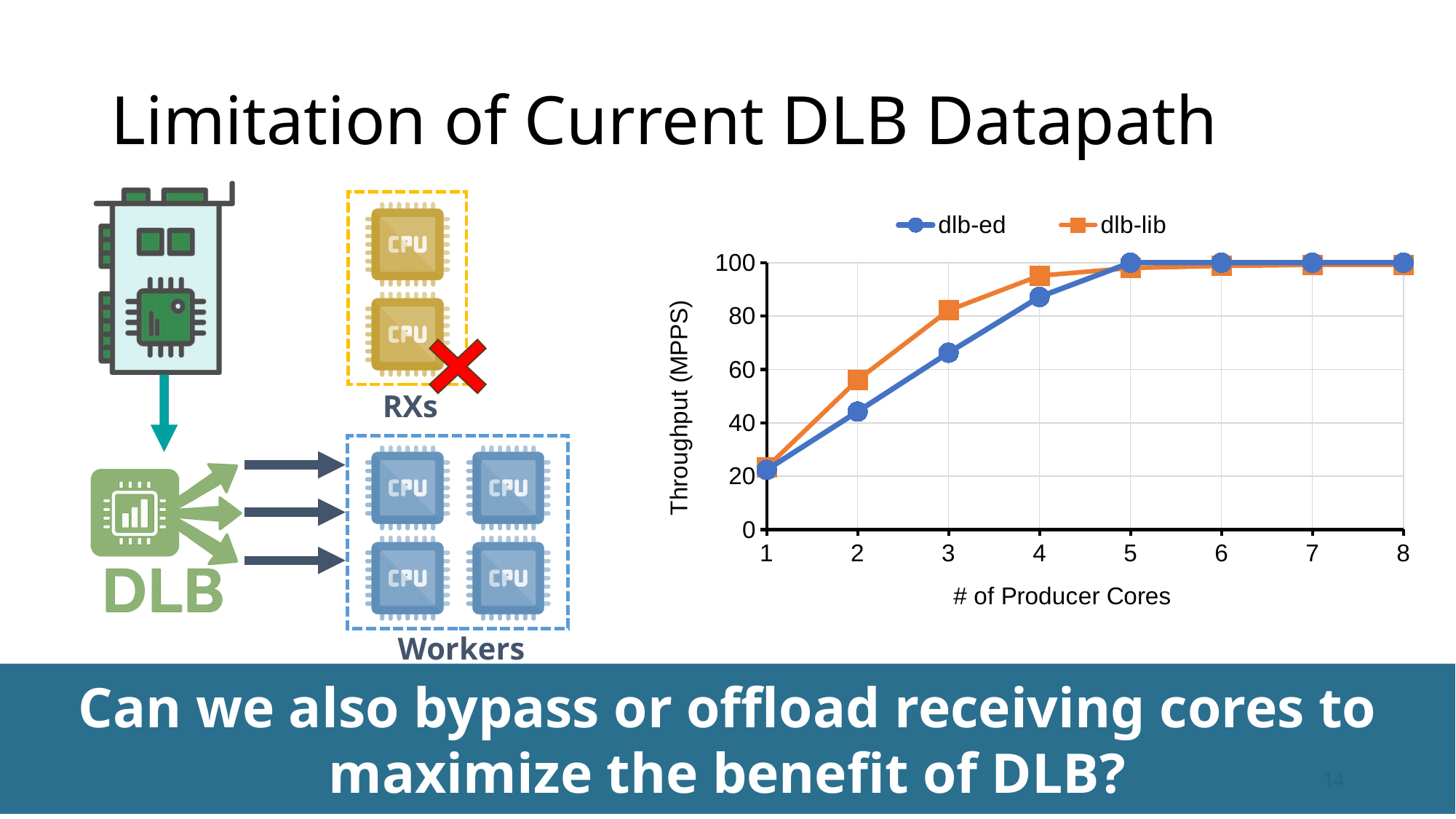
At 2 producer cores, which series has the higher throughput, dlb-ed or dlb-lib? dlb-lib What is the label of the y axis of the chart? Throughput (MPPS) How many producer-core values are plotted along the x axis of the chart? 8 Is the throughput of dlb-lib at 3 producer cores greater or less than 60? greater What kind of chart is shown on the slide? line chart How many series does the chart legend list? 2 Is the throughput of dlb-ed at 4 producer cores greater or less than 80? greater What is the label of the x axis of the chart? # of Producer Cores How does the throughput of dlb-ed change as the number of producer cores increases from 1 to 8? rises, then levels off at about 5 cores Is the throughput of dlb-ed at 2 producer cores greater or less than 60? less At 3 producer cores, which series has the higher throughput, dlb-ed or dlb-lib? dlb-lib